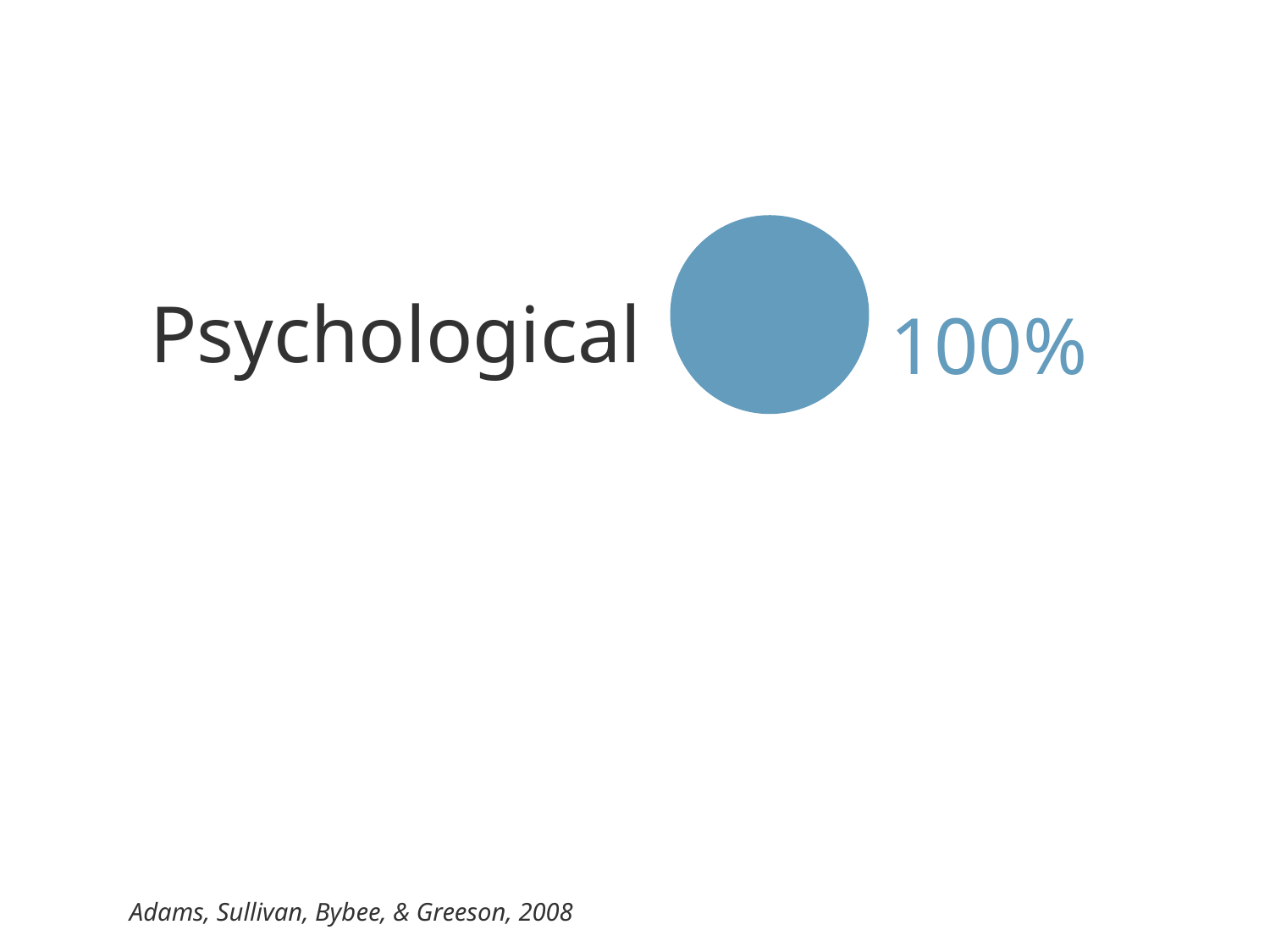
What percentage is shown next to the circle for Psychological? 100% What share of the pie does the Psychological slice take up? 100% What colour is the pie chart? blue What is the label of the category shown on the chart? Psychological How many categories does the chart show? 1 What kind of chart is shown on the slide? pie chart